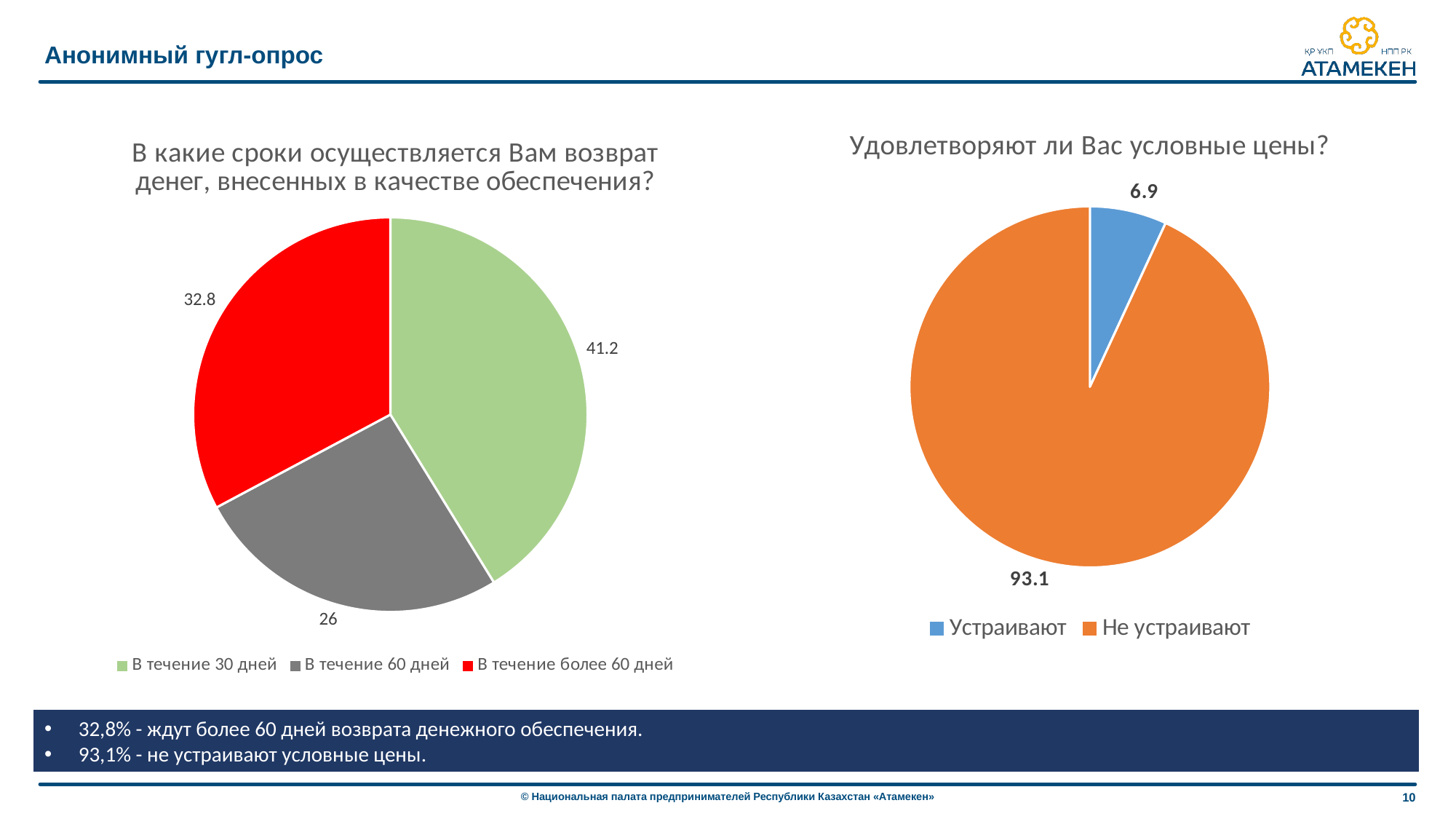
In the left chart (В какие сроки осуществляется Вам возврат денег, внесенных в качестве обеспечения?), what is the value for 'В течение 60 дней'? 26 In the right chart (Удовлетворяют ли Вас условные цены?), which is larger: 'Устраивают' or 'Не устраивают'? Не устраивают In the right chart (Удовлетворяют ли Вас условные цены?), what is the value for 'Не устраивают'? 93.1 In the left chart (В какие сроки осуществляется Вам возврат денег, внесенных в качестве обеспечения?), what is the value for 'В течение более 60 дней'? 32.8 In the left chart (В какие сроки осуществляется Вам возврат денег, внесенных в качестве обеспечения?), which category has the smallest slice? В течение 60 дней In the left chart (В какие сроки осуществляется Вам возврат денег, внесенных в качестве обеспечения?), what is the value for 'В течение 30 дней'? 41.2 In the left chart (В какие сроки осуществляется Вам возврат денег, внесенных в качестве обеспечения?), what is the difference between the values for 'В течение 30 дней' and 'В течение 60 дней'? 15.2 In the left chart (В какие сроки осуществляется Вам возврат денег, внесенных в качестве обеспечения?), what colour is the slice for 'В течение более 60 дней'? Red In the left chart (В какие сроки осуществляется Вам возврат денег, внесенных в качестве обеспечения?), how many categories are shown? 3 In the left chart (В какие сроки осуществляется Вам возврат денег, внесенных в качестве обеспечения?), which category has the largest slice? В течение 30 дней In the right chart (Удовлетворяют ли Вас условные цены?), what is the value for 'Устраивают'? 6.9 What type of chart is the right chart (Удовлетворяют ли Вас условные цены?)? Pie chart